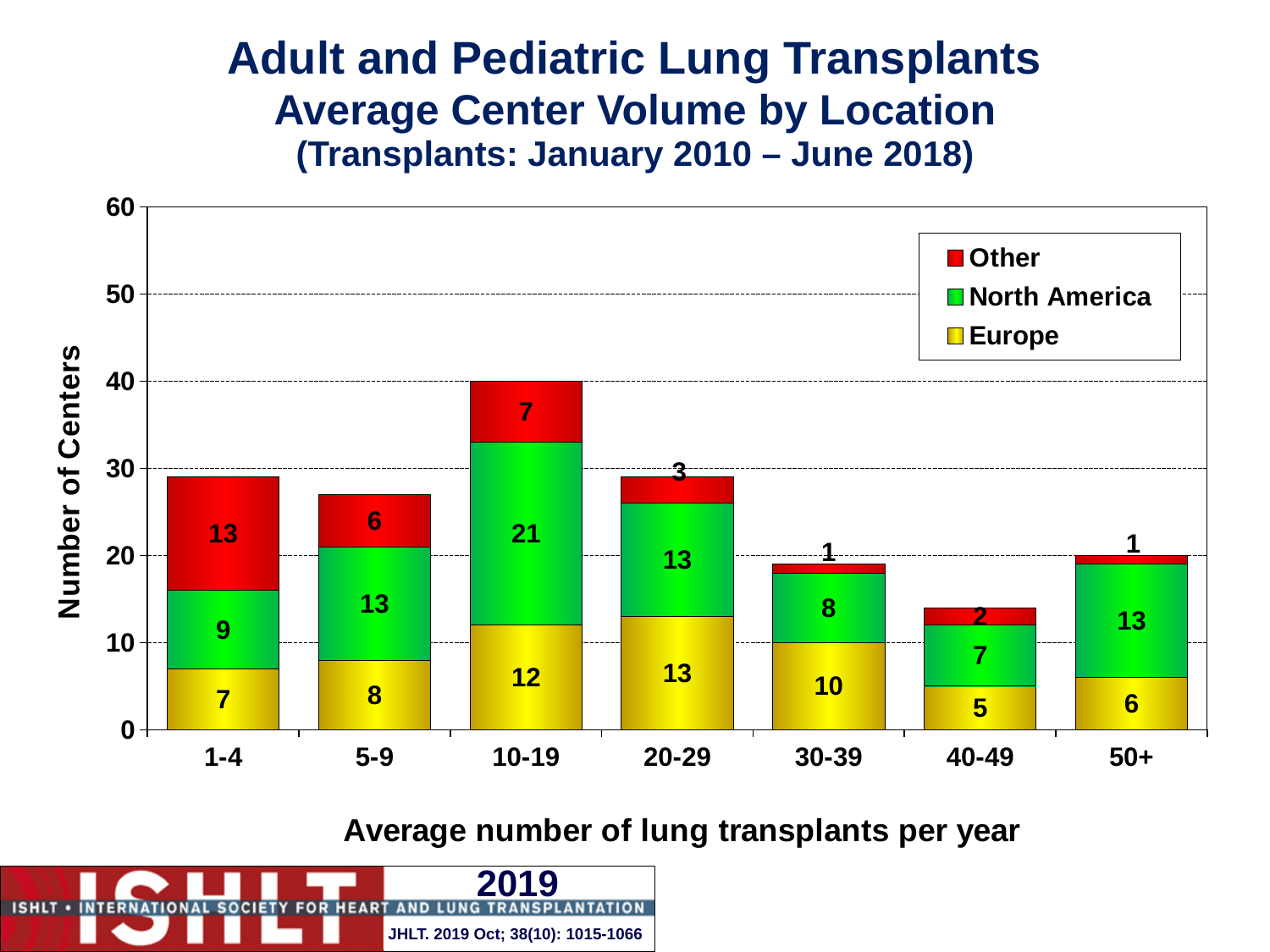
What is the difference between the North America value and the Europe value in the 10-19 category? 9 Which category has the highest North America value? 10-19 How many series does the legend list? 3 How many centers in Europe have an average of 10-19 lung transplants per year? 12 What kind of chart is shown on the slide? Stacked bar chart What is the Other value for the 1-4 category? 13 What is the total number of centers in the 40-49 category across all three regions? 14 What is the North America value for the 5-9 category? 13 What is the total number of centers in the 10-19 category across all three regions? 40 How many categories are shown on the x axis? 7 Which is larger, the Other value for 1-4 or the Other value for 5-9? 1-4 Which category has the lowest Europe value? 40-49